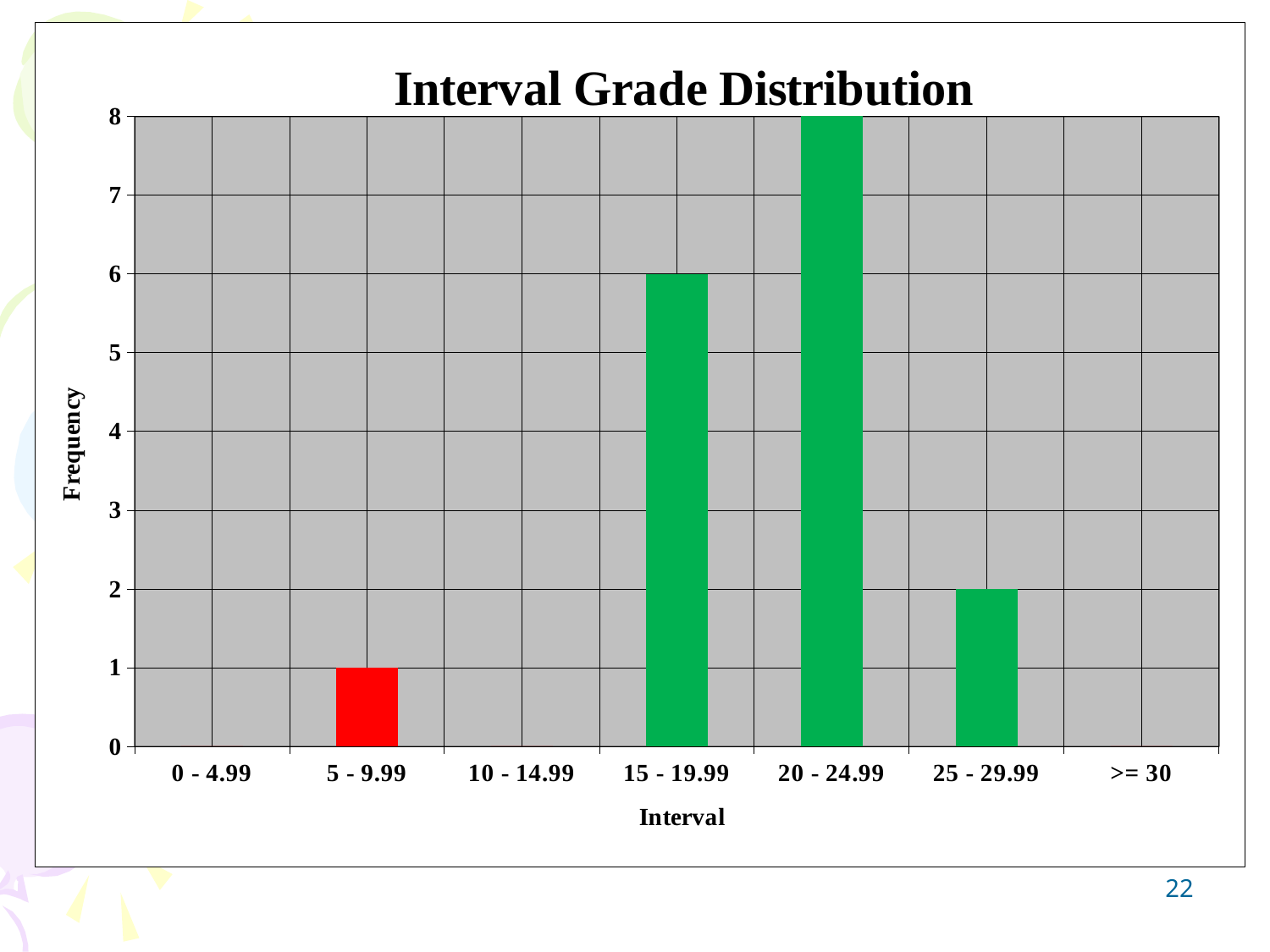
What type of chart is shown on the slide? bar chart Which has a higher frequency, the 25 - 29.99 interval or the 5 - 9.99 interval? 25 - 29.99 What is the frequency for the 5 - 9.99 interval? 1 What colour is the bar for the 5 - 9.99 interval? red What is the frequency for the 15 - 19.99 interval? 6 What is the frequency for the 20 - 24.99 interval? 8 Is the frequency for the 15 - 19.99 interval greater or less than 5? greater What is the frequency for the 25 - 29.99 interval? 2 Which interval has the highest frequency? 20 - 24.99 What is the title of the chart? Interval Grade Distribution How many interval categories are shown on the x axis? 7 What is the difference in frequency between the 20 - 24.99 and 15 - 19.99 intervals? 2